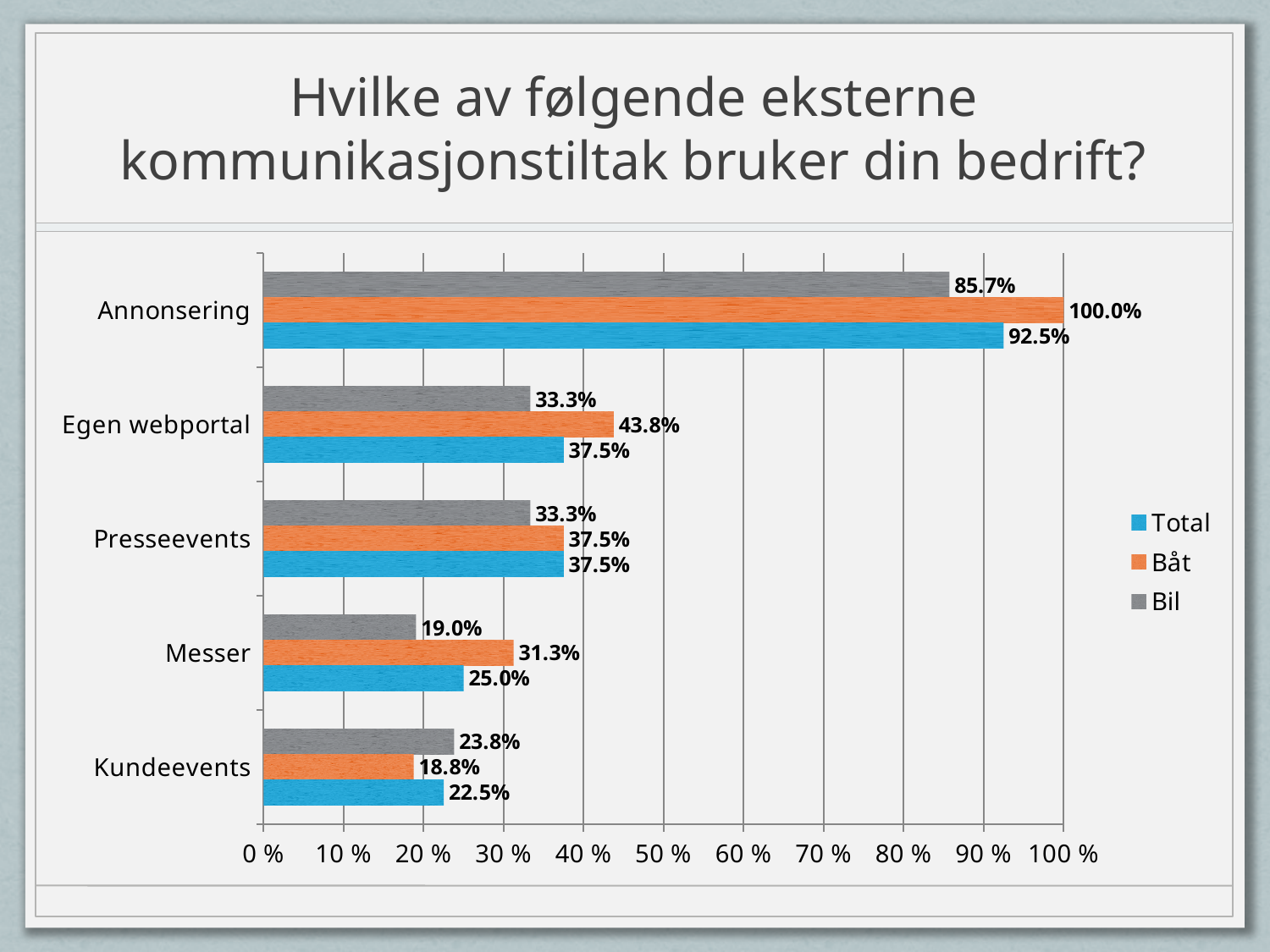
What is the Bil value for Messer? 19.0% What is the Båt value for Annonsering? 100.0% Which is larger for Kundeevents, the Bil value or the Båt value? Bil Which series is shown in orange? Båt Which category has the highest Total value? Annonsering Is the Total value for Messer greater or less than 30 %? less How many series does the legend list? 3 What is the Total value for Egen webportal? 37.5% What is the difference between the Båt and Bil values for Annonsering? 14.3% What kind of chart is shown on the slide? bar chart Which category has the lowest Båt value? Kundeevents How many categories are shown on the chart? 5